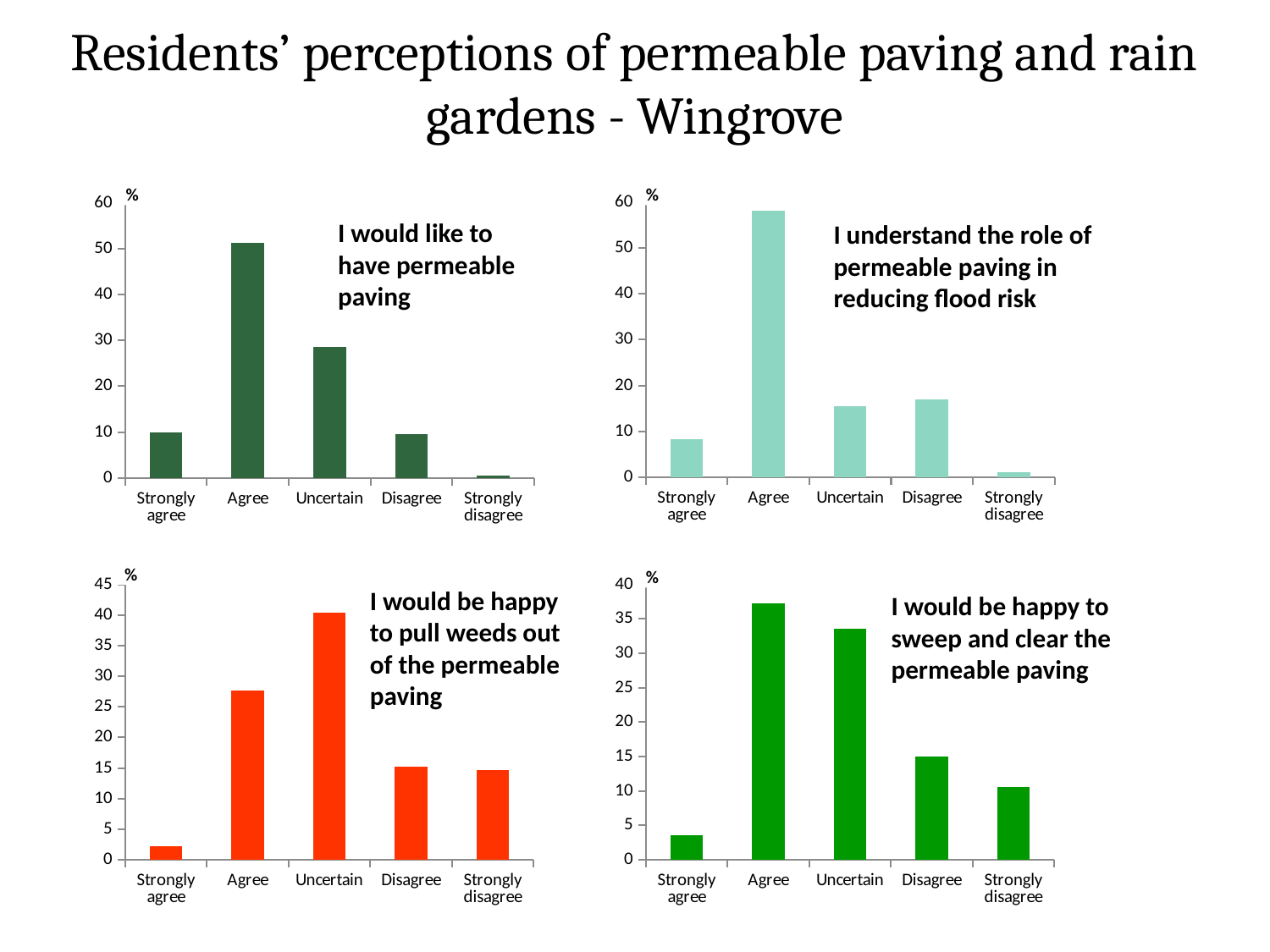
In the chart titled "I understand the role of permeable paving in reducing flood risk", is the value for Agree greater or less than 50? greater What type of chart is the chart titled "I would like to have permeable paving"? bar chart In the chart titled "I would be happy to pull weeds out of the permeable paving", is the value for Uncertain greater or less than 35? greater In the chart titled "I would be happy to sweep and clear the permeable paving", is the value for Disagree greater or less than 20? less In the chart titled "I would be happy to pull weeds out of the permeable paving", which response category has the highest value? Uncertain How many response categories are shown on the x axis of the chart titled "I would be happy to sweep and clear the permeable paving"? 5 In the chart titled "I would be happy to sweep and clear the permeable paving", which response category has the lowest value? Strongly agree In the chart titled "I would like to have permeable paving", which response category has the lowest value? Strongly disagree In the chart titled "I understand the role of permeable paving in reducing flood risk", which response category has the lowest value? Strongly disagree In the chart titled "I would be happy to pull weeds out of the permeable paving", which is larger, Agree or Disagree? Agree In the chart titled "I would like to have permeable paving", which response category has the highest value? Agree